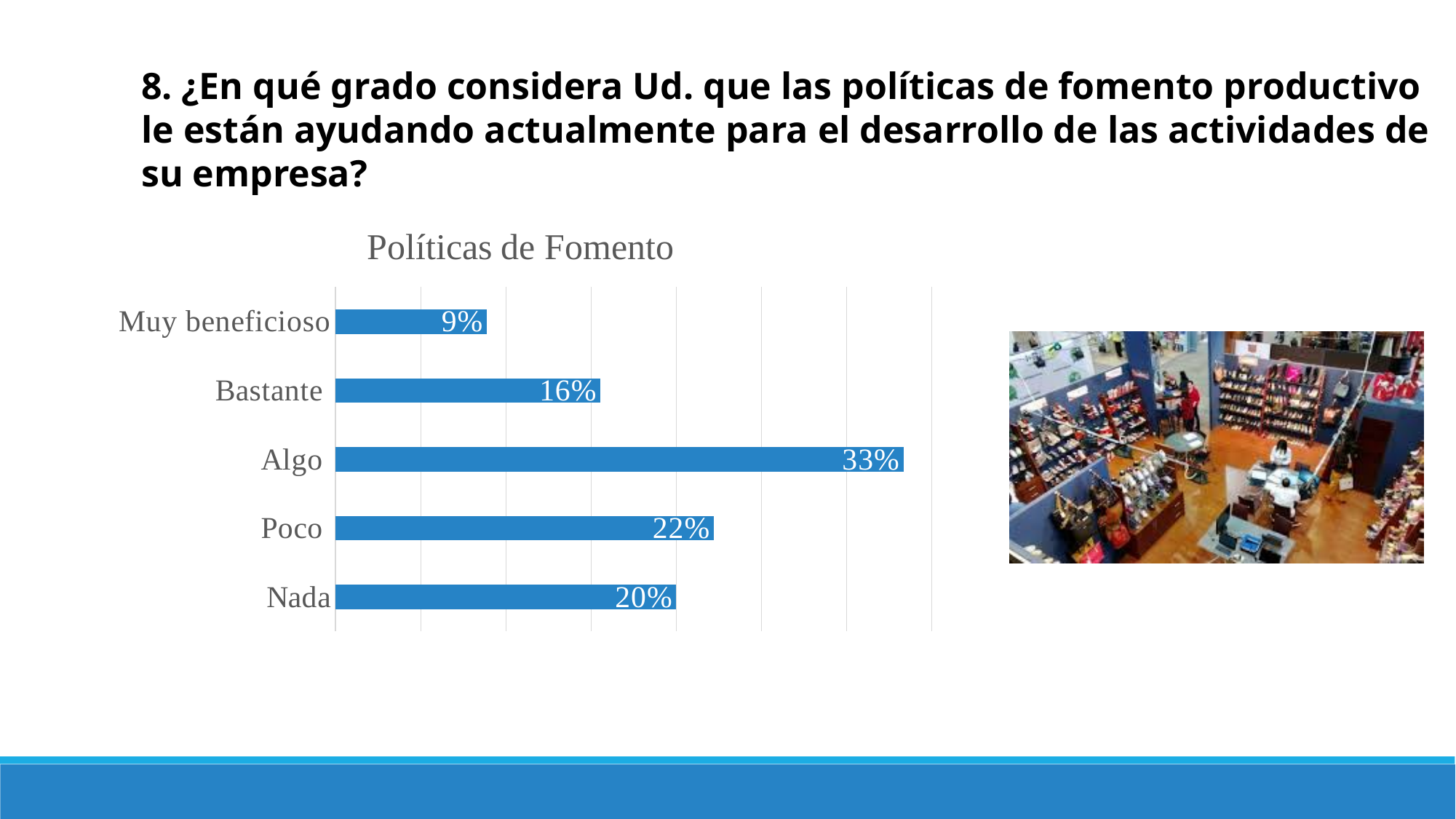
What is the value for "Bastante"? 16% Which category has the highest value? Algo What is the difference between the values for "Bastante" and "Muy beneficioso"? 7% What is the value for "Algo"? 33% What is the title of the chart? Políticas de Fomento What kind of chart is shown on the slide? Bar chart What is the difference between the values for "Algo" and "Poco"? 11% What is the value for "Nada"? 20% What is the value for "Muy beneficioso"? 9% How many categories are shown in the chart? 5 Which category has the lowest value? Muy beneficioso Which is larger, the value for "Poco" or the value for "Nada"? Poco